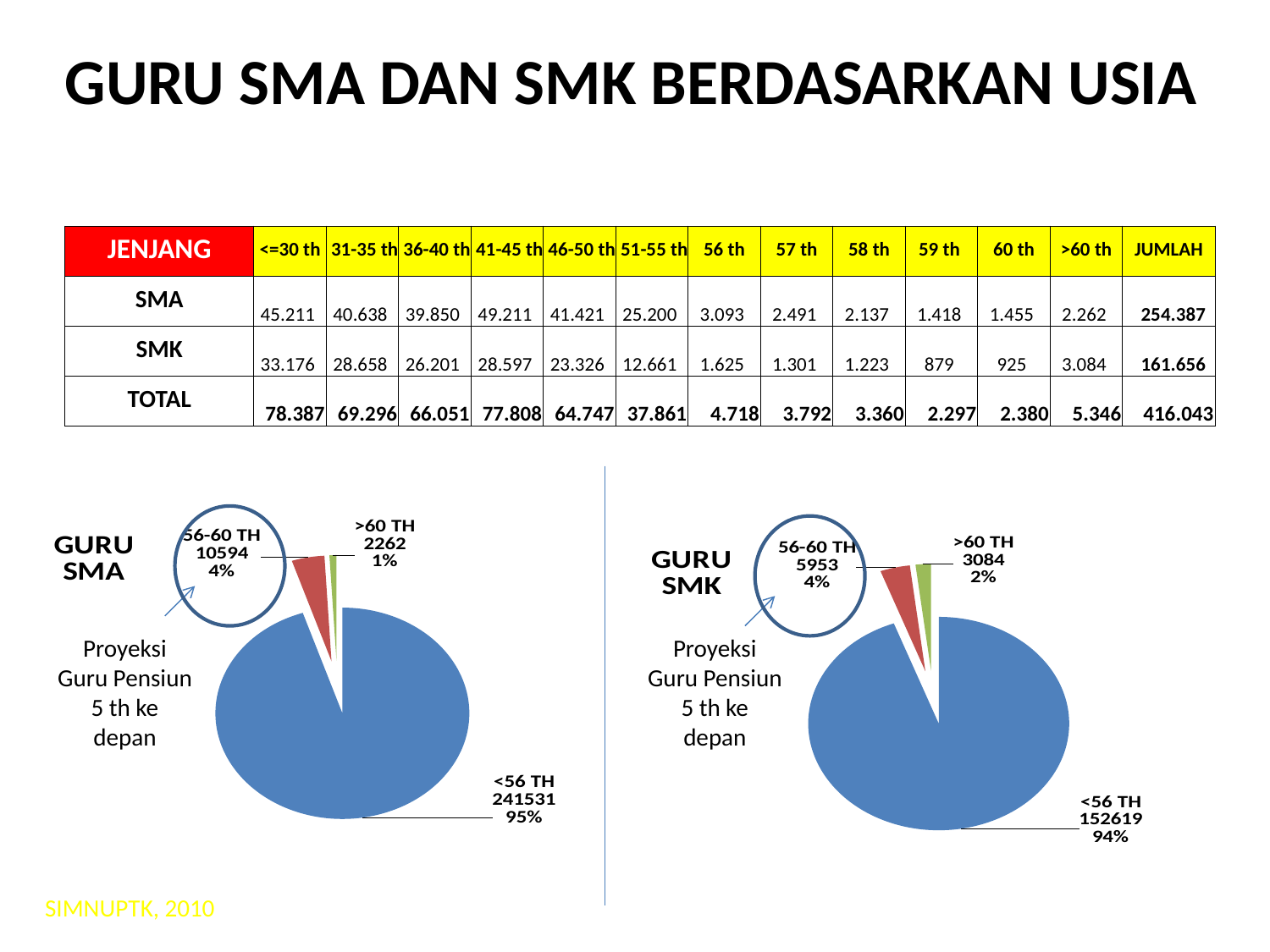
Which is larger: the >60 TH value in the GURU SMA chart or the >60 TH value in the GURU SMK chart? GURU SMK In the GURU SMA pie chart, what is the value for the <56 TH slice? 241531 In the GURU SMA pie chart, which slice is the smallest? >60 TH In the GURU SMA pie chart, what share of the pie does the 56-60 TH slice represent? 4% In the GURU SMA pie chart, what is the value for the >60 TH slice? 2262 In the GURU SMK pie chart, what share of the pie does the >60 TH slice represent? 2% In the GURU SMK pie chart, what is the value for the 56-60 TH slice? 5953 In the GURU SMK pie chart, what is the value for the <56 TH slice? 152619 In the GURU SMK pie chart, which slice is the largest? <56 TH In the GURU SMA pie chart, how many slices are there? 3 What kind of chart is the GURU SMA chart on the left? Pie chart In the GURU SMK pie chart, what is the difference between the 56-60 TH value and the >60 TH value? 2869